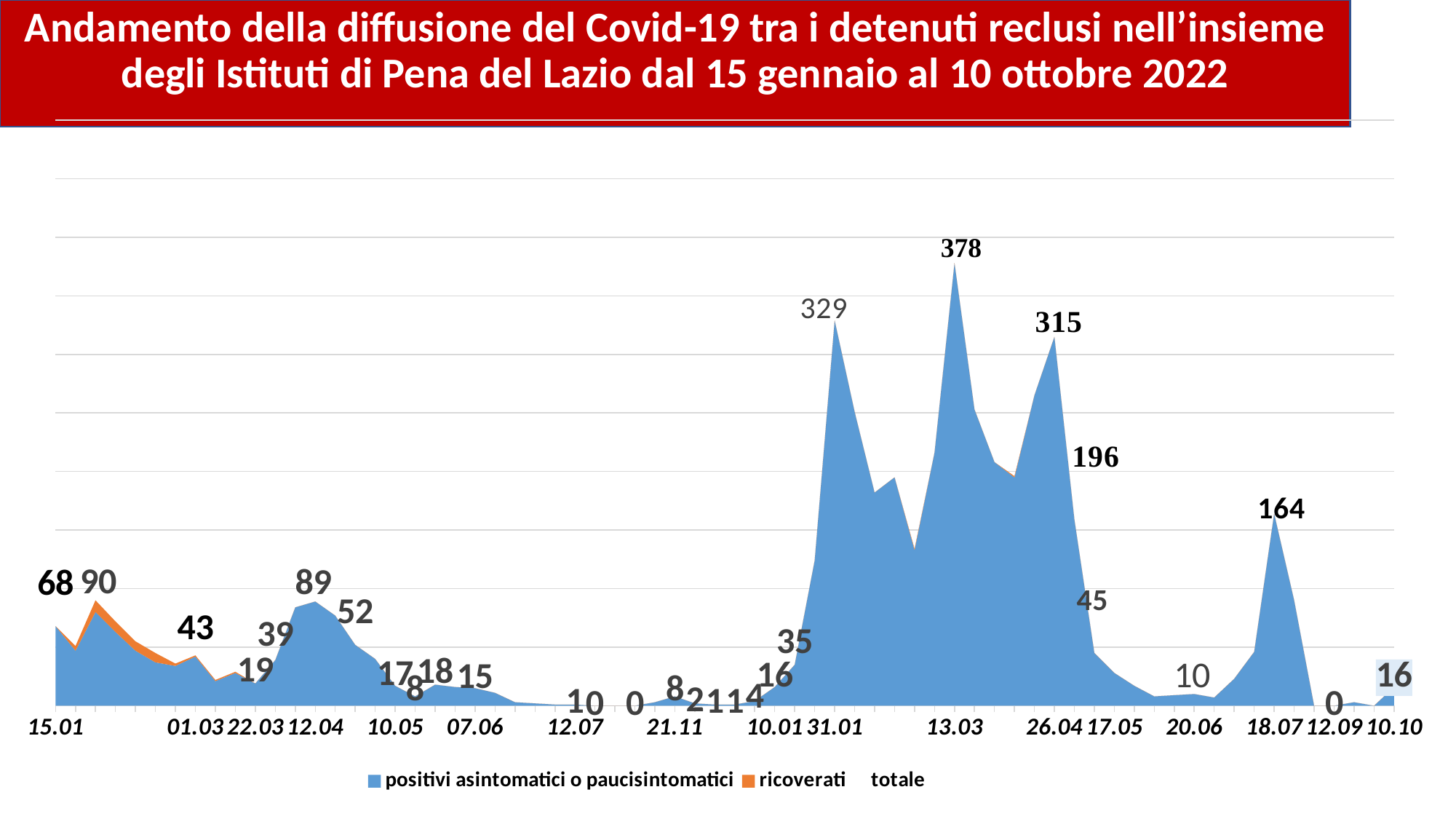
What is the difference between the peak value at 13.03 (378) and the value at 26.04 (315)? 63 What is the value labelled at 18.07? 164 What is the highest value labelled on the chart? 378 What is the value labelled at 13.03? 378 How many series does the legend list? 3 Do the values rise or fall from 13.03 to 17.05? fall Which is larger, the value at 31.01 or the value at 26.04? 31.01 What is the value labelled at 12.09? 0 What is the value labelled at 10.10, the last date on the x axis? 16 What is the name of the first series in the legend? positivi asintomatici o paucisintomatici What is the value labelled at 31.01? 329 What kind of chart is shown on the slide? area chart